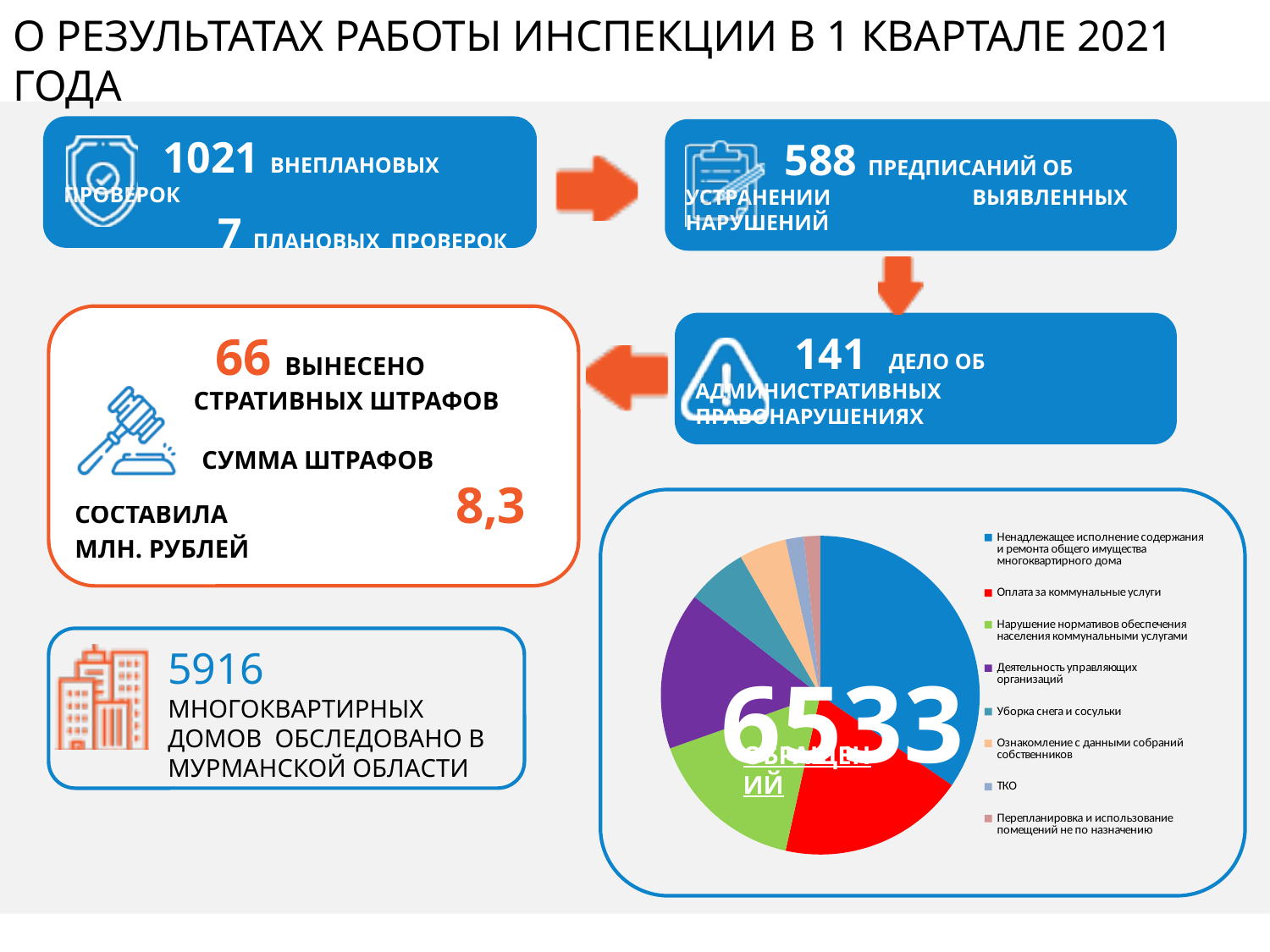
Which slice is larger: "Ненадлежащее исполнение содержания и ремонта общего имущества многоквартирного дома" or "Деятельность управляющих организаций"? Ненадлежащее исполнение содержания и ремонта общего имущества многоквартирного дома What colour represents "Оплата за коммунальные услуги" in the pie chart? red How many entries does the legend of the pie chart list? 8 What kind of chart is shown on the slide? pie chart What number is printed in the centre of the pie chart? 6533 Which slice is larger: "Нарушение нормативов обеспечения населения коммунальными услугами" or "ТКО"? Нарушение нормативов обеспечения населения коммунальными услугами How many categories (slices) does the pie chart have? 8 Which category has the largest slice in the pie chart? Ненадлежащее исполнение содержания и ремонта общего имущества многоквартирного дома Which slice is larger: "Оплата за коммунальные услуги" or "Уборка снега и сосульки"? Оплата за коммунальные услуги